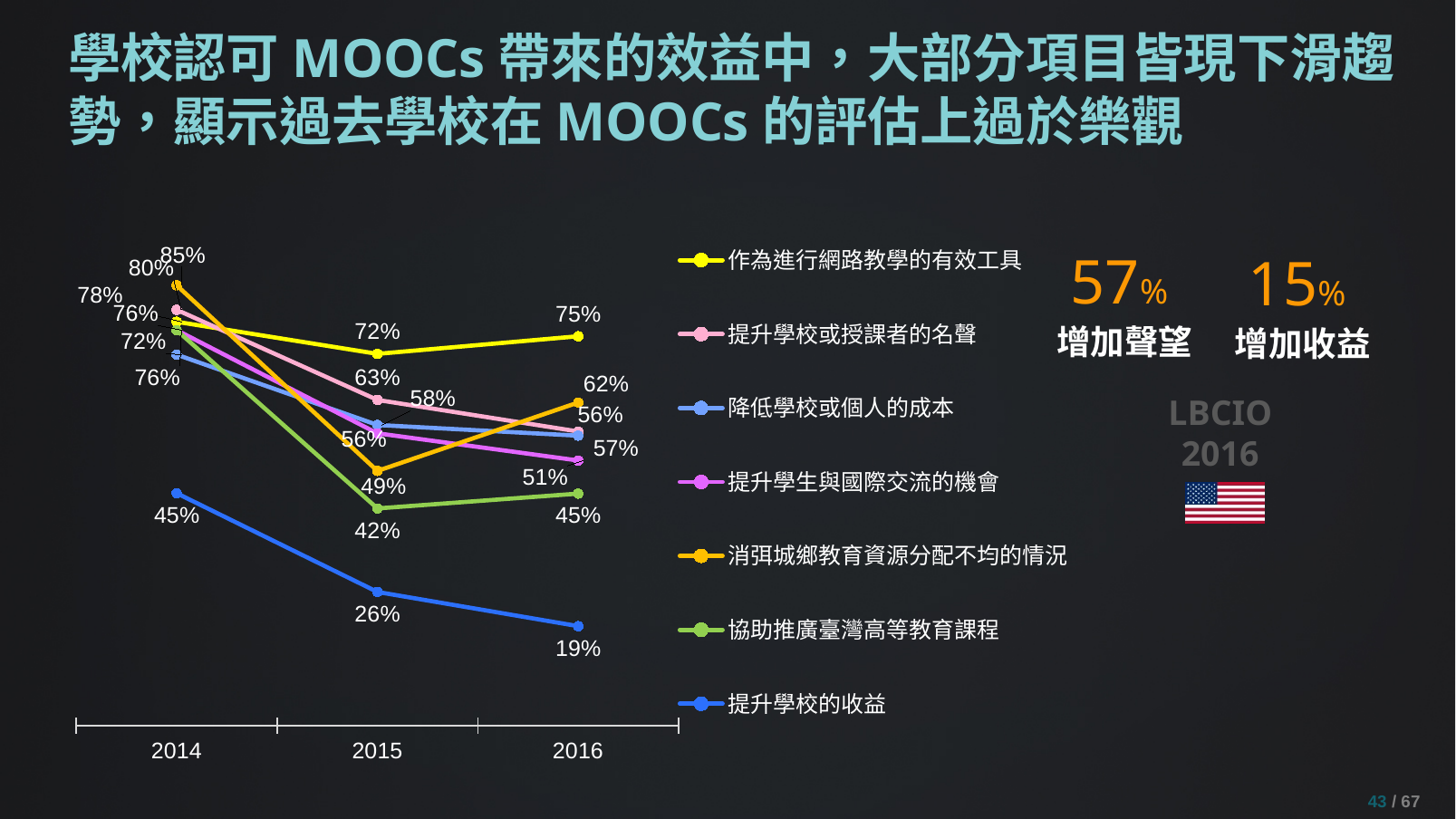
Which series has the lowest value in 2016? 提升學校的收益 What is the value for 協助推廣臺灣高等教育課程 in 2015? 42% What is the value for 消弭城鄉教育資源分配不均的情況 in 2015? 49% What is the value for 提升學校的收益 in 2015? 26% Which series has the highest value in 2016? 作為進行網路教學的有效工具 What is the value for 提升學校的收益 in 2016? 19% In 2016, which is larger: 消弭城鄉教育資源分配不均的情況 or 協助推廣臺灣高等教育課程? 消弭城鄉教育資源分配不均的情況 How many years are shown on the x axis? 3 How many series does the legend list? 7 By how many percentage points did 提升學校的收益 fall from 2014 to 2016? 26 What kind of chart is shown on the slide? line chart What is the value for 作為進行網路教學的有效工具 in 2016? 75%